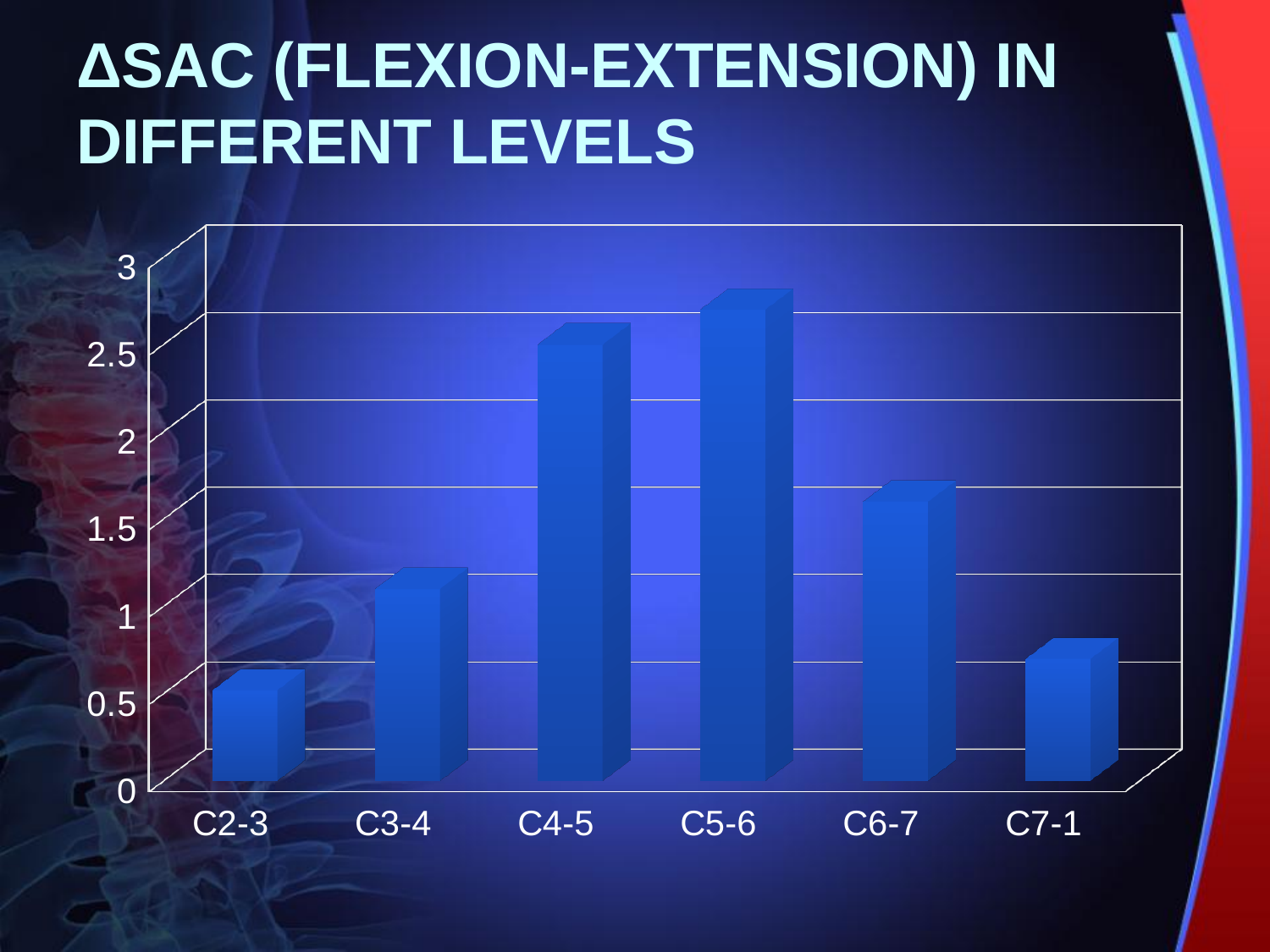
How many levels (categories) are plotted on the x axis? 6 Is the value for C4-5 greater or less than 2? greater Is the value for C7-1 greater or less than 1? less Is the value for C5-6 greater or less than 2.5? greater Which level has the lowest ΔSAC value? C2-3 What is the title of the slide containing the chart? ΔSAC (FLEXION-EXTENSION) IN DIFFERENT LEVELS Which level has the highest ΔSAC value? C5-6 Do the values rise or fall going from C5-6 to C7-1 along the x axis? fall Which is larger, the value for C4-5 or the value for C6-7? C4-5 What kind of chart is shown on the slide? bar chart